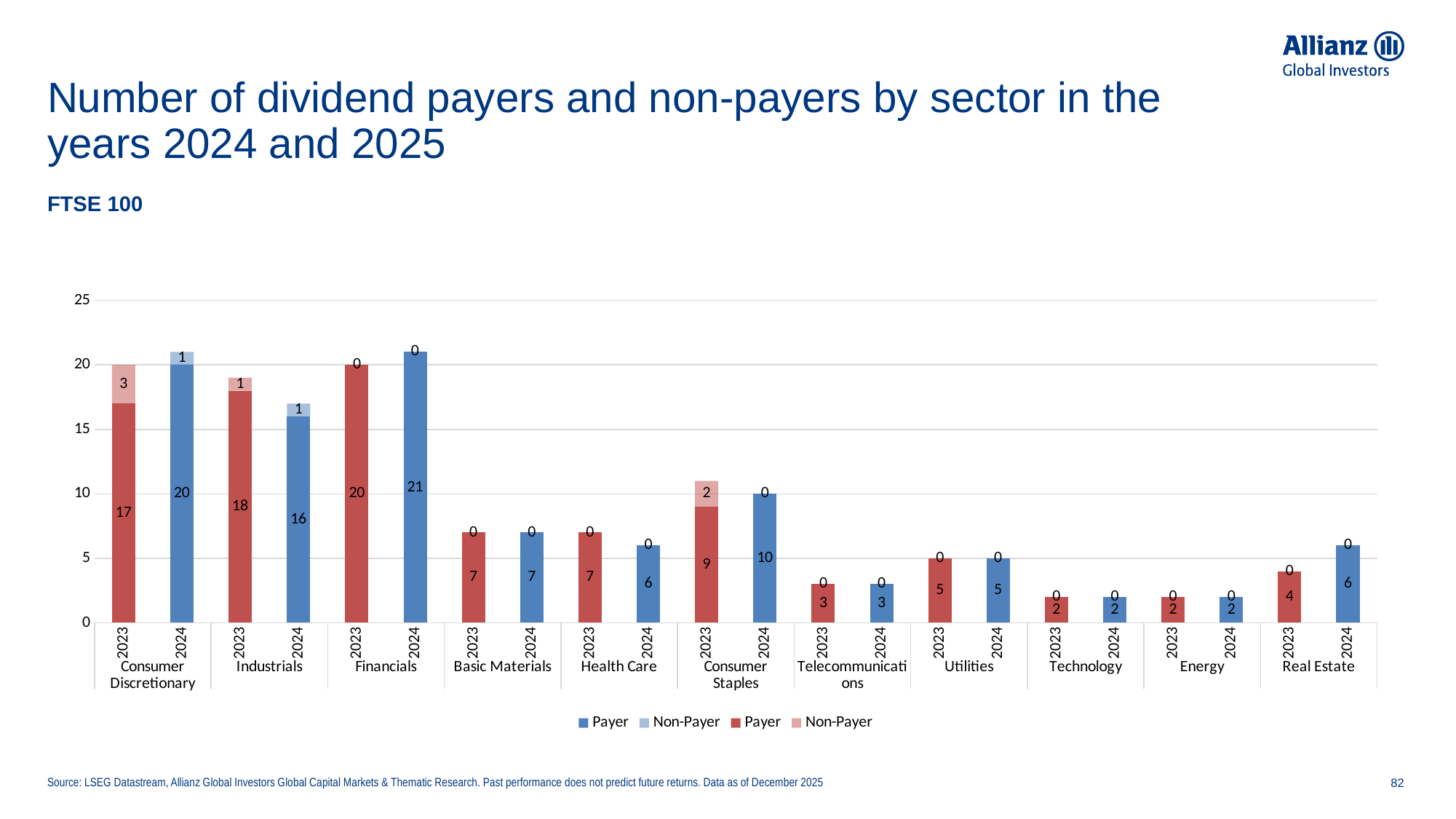
What is the difference between the number of payers in Consumer Discretionary in 2024 and in 2023? 3 What is the number of non-payers for Consumer Discretionary in 2023? 3 Which sector has the highest number of dividend payers in 2024? Financials Which index does the chart cover, according to the subtitle? FTSE 100 How many dividend payers are shown for Industrials in 2024? 16 Which is larger: the number of payers in Real Estate in 2024 or in 2023? 2024 How many sectors are shown on the x axis of the chart? 11 How many entries does the chart legend list? 4 What kind of chart is shown on the slide? Stacked bar chart How many dividend payers does the chart show for Financials in 2024? 21 What is the total height of the stacked bar for Consumer Discretionary in 2023 (payers plus non-payers)? 20 What is the total of the stacked bar for Consumer Staples in 2023? 11